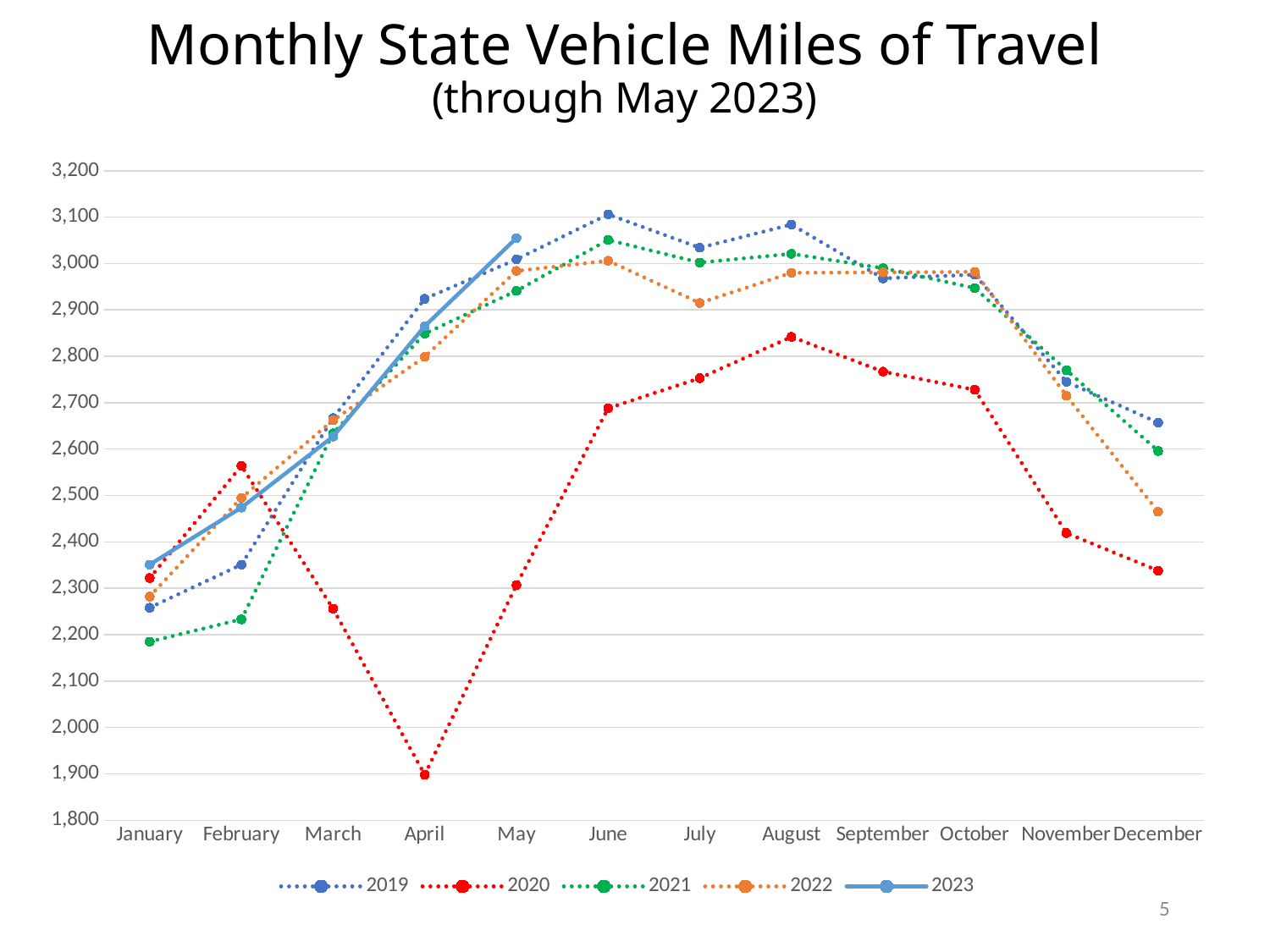
In the 2020 series, which month has the highest value? August In the 2020 series, which month has the lowest value? April How many months are shown along the x axis? 12 Which series is drawn as a solid line rather than a dotted line? 2023 Is the value for January in the 2021 series greater or less than 2,300? less How many series does the legend list? 5 Is the value for May in the 2023 series greater or less than 3,000? greater What kind of chart is shown on the slide? line chart Does the 2023 series rise or fall from January to May? rise Which series has the larger value in December, 2020 or 2022? 2022 Is the value for April in the 2020 series greater or less than 2,000? less Which series has the larger value in January, 2023 or 2021? 2023